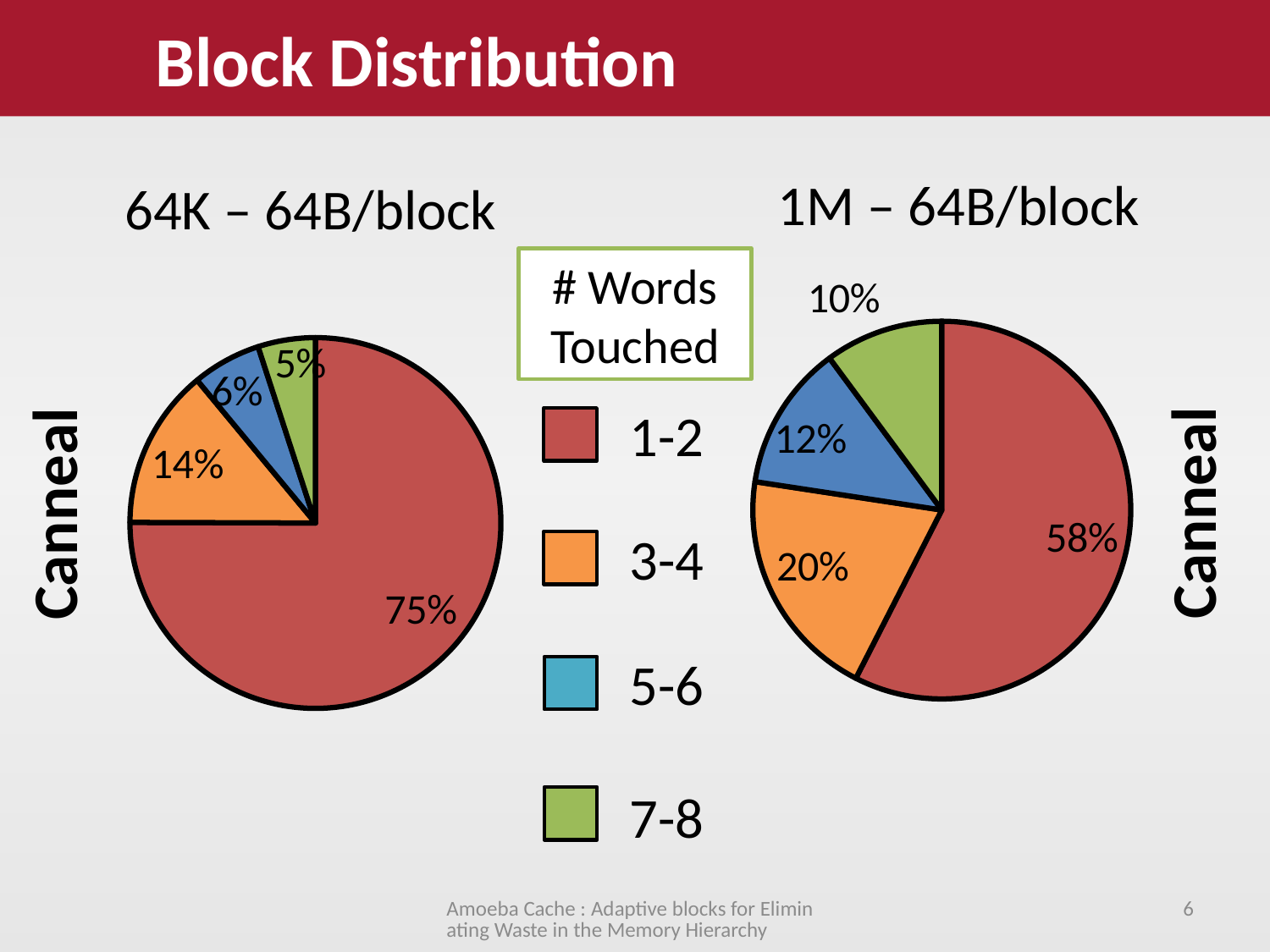
In the 1M – 64B/block chart, which category has the largest slice? 1-2 In the 1M – 64B/block chart, what share of blocks have 3-4 words touched? 20% In the 64K – 64B/block chart, what share of blocks have 1-2 words touched? 75% What is the title of the legend shared by the two charts? # Words Touched What is the difference between the 1-2 share in the 64K – 64B/block chart and the 1-2 share in the 1M – 64B/block chart? 17% In the 64K – 64B/block chart, which category has the smallest slice? 7-8 In the 1M – 64B/block chart, what share of blocks have 5-6 words touched? 12% In the 64K – 64B/block chart, what is the difference between the 3-4 share and the 5-6 share? 8% What kind of chart is used for the 64K – 64B/block data? Pie chart Which chart has the larger share for 7-8 words touched, 64K – 64B/block or 1M – 64B/block? 1M – 64B/block In the 64K – 64B/block chart, what share of blocks have 7-8 words touched? 5% How many slices does the 1M – 64B/block pie chart have? 4